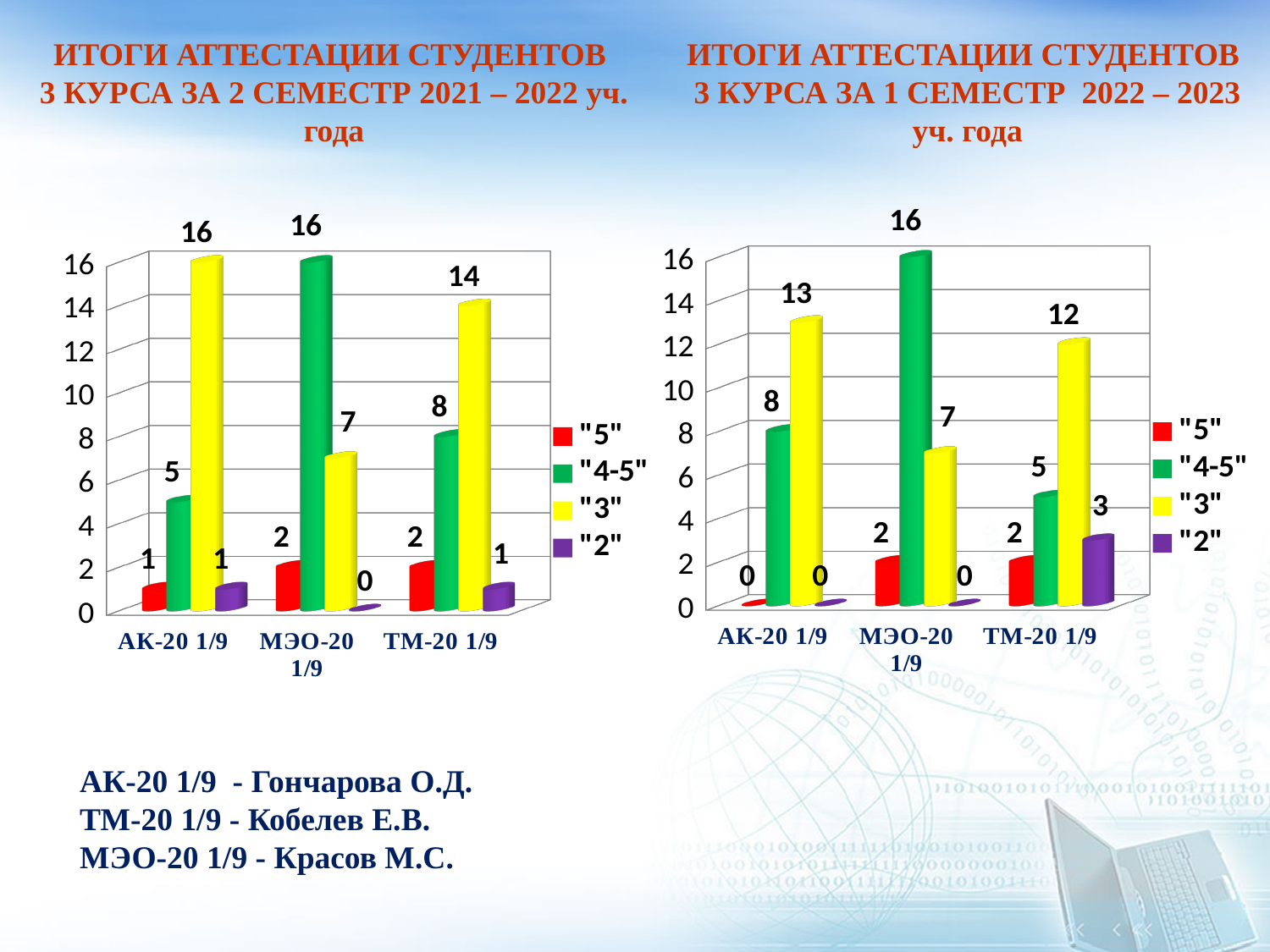
In the right chart, which category has the lowest value for the "3" series? МЭО-20 1/9 In the left chart, what is the difference between the "3" values for АК-20 1/9 and ТМ-20 1/9? 2 In the left chart, what is the value of the "3" series for АК-20 1/9? 16 In the right chart, what is the value of the "2" series for ТМ-20 1/9? 3 In the right chart, which is larger for ТМ-20 1/9: the "4-5" value or the "3" value? "3" How many categories are shown on the x axis of the left chart? 3 How many series does the legend of the right chart list? 4 In the left chart, which colour represents the "2" series? Purple In the right chart, what is the value of the "4-5" series for МЭО-20 1/9? 16 In the left chart, which category has the highest value for the "4-5" series? МЭО-20 1/9 In the right chart, what is the total of all four series for АК-20 1/9? 21 What type of chart is the left chart? Bar chart